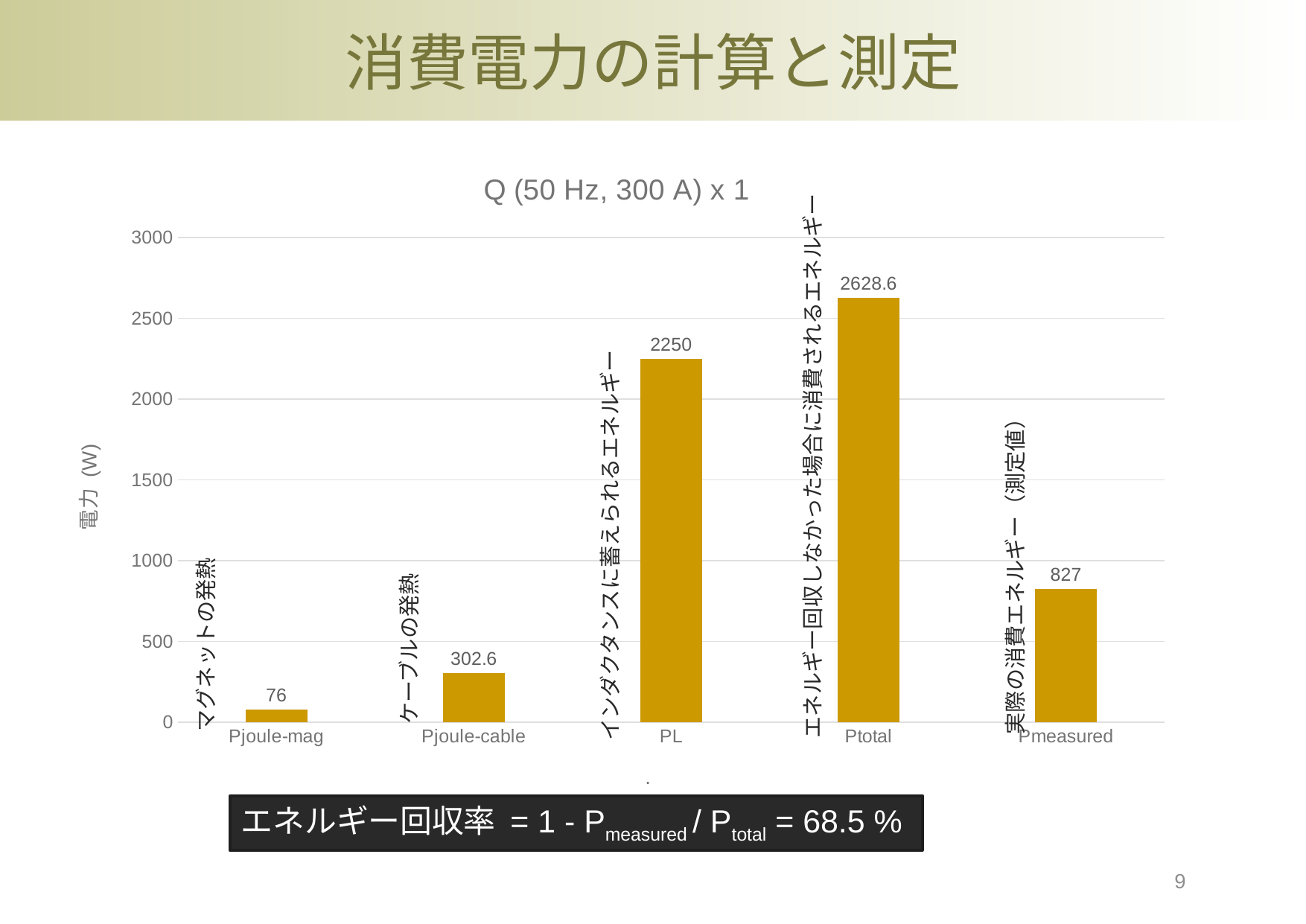
What is the value for Pjoule-cable? 302.6 What is the title of the chart? Q (50 Hz, 300 A) x 1 What kind of chart is shown? bar chart Which is larger, PL or Pmeasured? PL Which category has the lowest value? Pjoule-mag Is the value for PL greater or less than 2000? greater What is the value for Ptotal? 2628.6 Which category has the highest value? Ptotal What is the difference between PL and Pjoule-cable? 1947.4 What is the value for Pmeasured? 827 What is the difference between Ptotal and Pmeasured? 1801.6 How many categories are shown on the x axis? 5